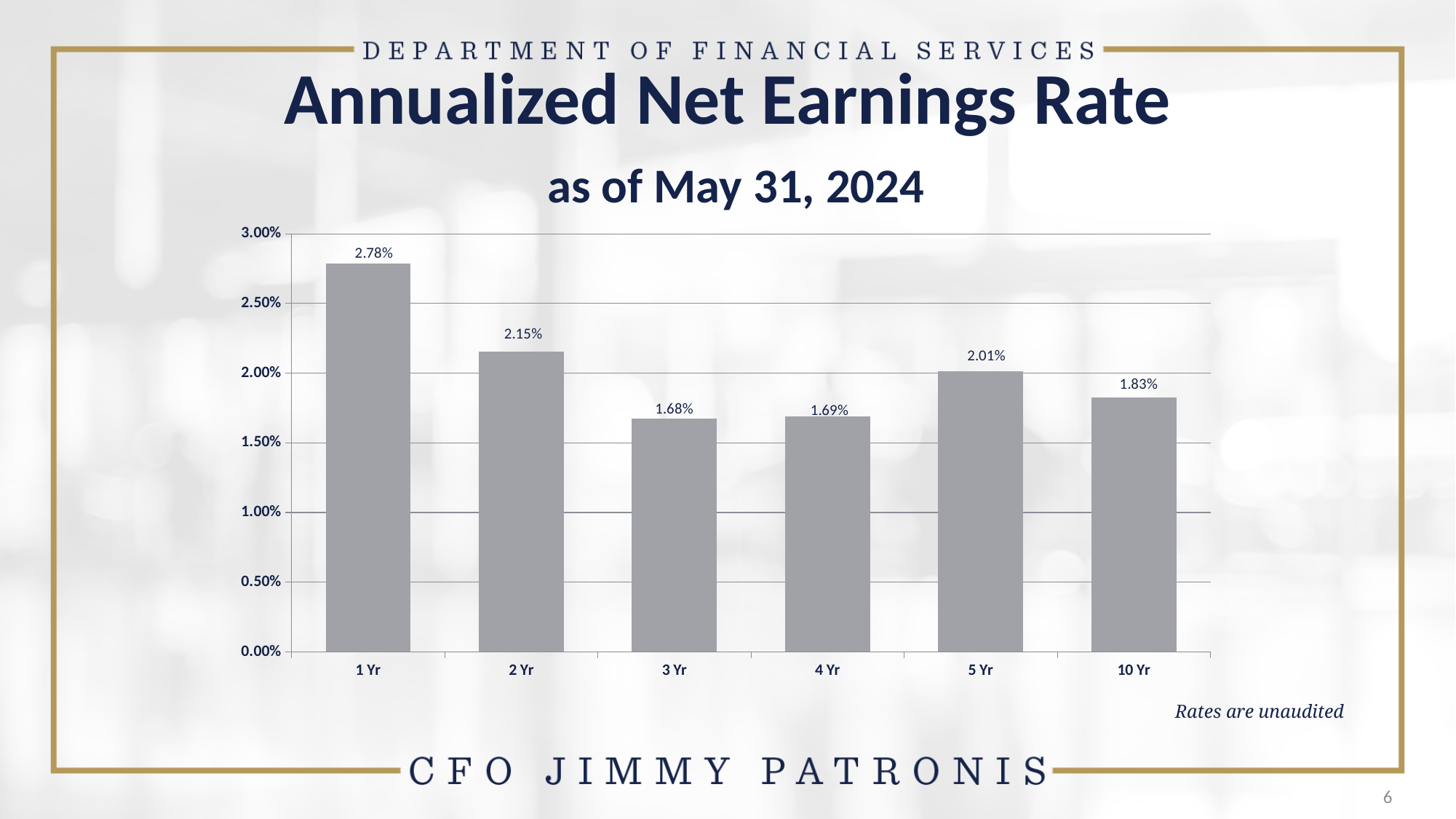
What kind of chart is shown on the slide? bar chart Which period has the lowest annualized net earnings rate? 3 Yr Is the value for 10 Yr greater or less than 2.00%? less As of what date are the annualized net earnings rates reported? May 31, 2024 Which is larger, the 2 Yr rate or the 5 Yr rate? 2 Yr What is the difference between the 5 Yr and 10 Yr annualized net earnings rates? 0.18% What is the annualized net earnings rate for 10 Yr? 1.83% Which period has the highest annualized net earnings rate? 1 Yr How many periods are shown on the chart? 6 What is the difference between the 1 Yr and 2 Yr annualized net earnings rates? 0.63% What is the annualized net earnings rate for 1 Yr? 2.78% What is the annualized net earnings rate for 5 Yr? 2.01%